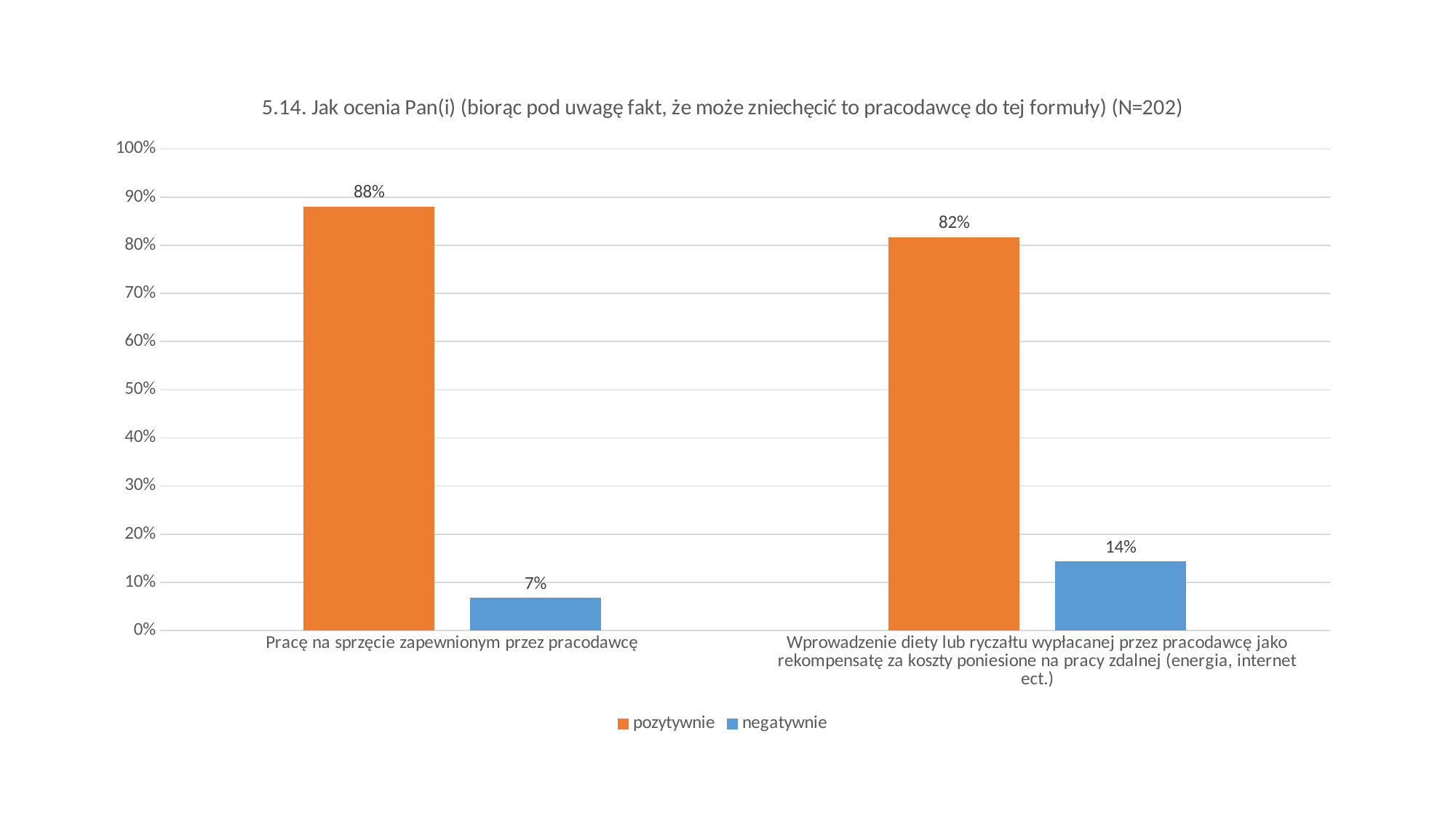
What is the difference between the 'negatywnie' values of the two categories? 7% What is the 'pozytywnie' value for 'Pracę na sprzęcie zapewnionym przez pracodawcę'? 88% Which category has the highest 'pozytywnie' value? Pracę na sprzęcie zapewnionym przez pracodawcę What kind of chart is shown on the slide? Bar chart What is the 'pozytywnie' value for 'Wprowadzenie diety lub ryczałtu wypłacanej przez pracodawcę jako rekompensatę za koszty poniesione na pracy zdalnej (energia, internet ect.)'? 82% How many categories are shown on the x axis? 2 Which is larger: the 'negatywnie' value for 'Pracę na sprzęcie zapewnionym przez pracodawcę' or the 'negatywnie' value for the 'Wprowadzenie diety lub ryczałtu' category? Wprowadzenie diety lub ryczałtu Which category has the lowest 'negatywnie' value? Pracę na sprzęcie zapewnionym przez pracodawcę What is the 'negatywnie' value for 'Wprowadzenie diety lub ryczałtu wypłacanej przez pracodawcę jako rekompensatę za koszty poniesione na pracy zdalnej (energia, internet ect.)'? 14% What is the difference between the 'pozytywnie' values of the two categories? 6% What is the 'negatywnie' value for 'Pracę na sprzęcie zapewnionym przez pracodawcę'? 7% How many series does the legend list? 2